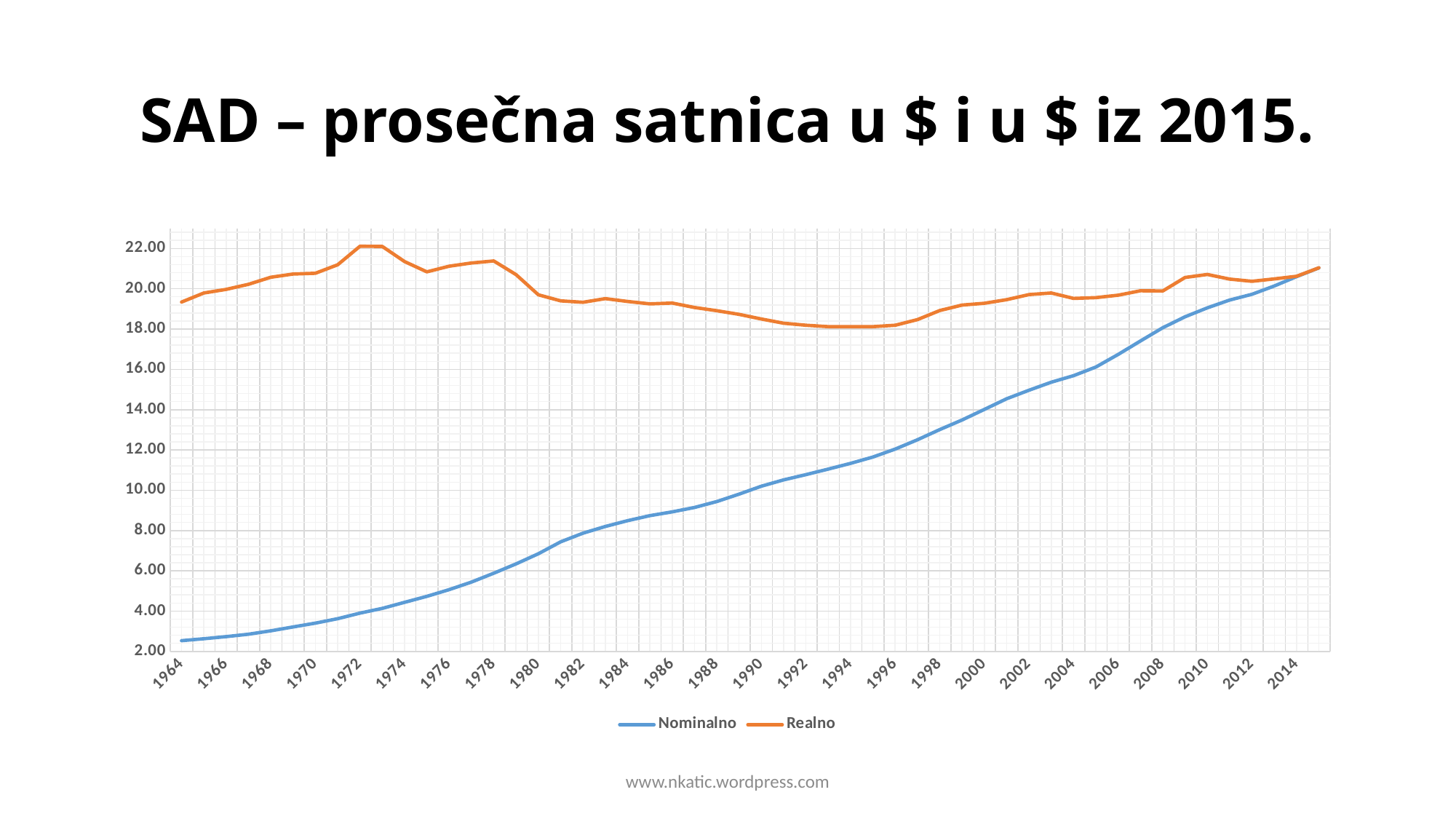
What are the names of the two series in the legend? Nominalno and Realno Does the Nominalno series rise or fall from 1964 to 2014? rise In which year is the Nominalno series at its lowest? 1964 Is the value for Realno in 1972 greater or less than 20.00? greater What is the title of the slide? SAD – prosečna satnica u $ i u $ iz 2015. In 1990, which series has the larger value, Nominalno or Realno? Realno Does the Realno series rise or fall between 1978 and 1994? fall Is the value for Nominalno in 2000 greater or less than 12.00? greater What kind of chart is shown on the slide? line chart Is the value for Realno in 1994 greater or less than 20.00? less How many series does the legend list? 2